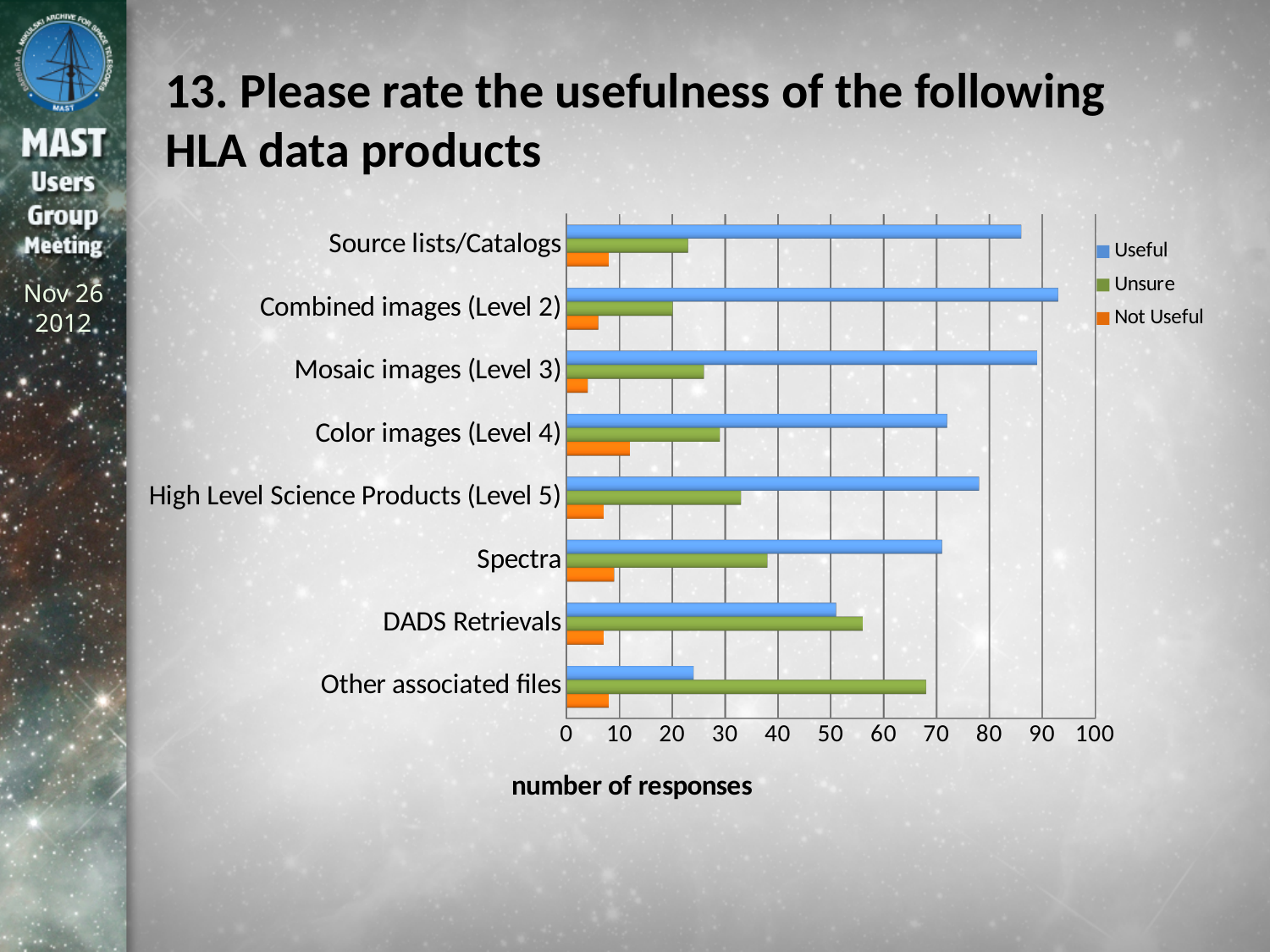
Is the 'Useful' value for High Level Science Products (Level 5) greater or less than 70? greater How many data products (categories) are listed on the chart? 8 What kind of chart is shown on the slide? bar chart Which data product has the highest number of 'Unsure' responses? Other associated files For DADS Retrievals, which is larger: the 'Useful' or the 'Unsure' count? Unsure Is the 'Unsure' value for Spectra greater or less than 30? greater Is the 'Useful' value for Source lists/Catalogs greater or less than 80? greater Which data product has the highest number of 'Not Useful' responses? Color images (Level 4) What is the label of the horizontal axis? number of responses Which data product has the lowest number of 'Useful' responses? Other associated files How many series does the legend list? 3